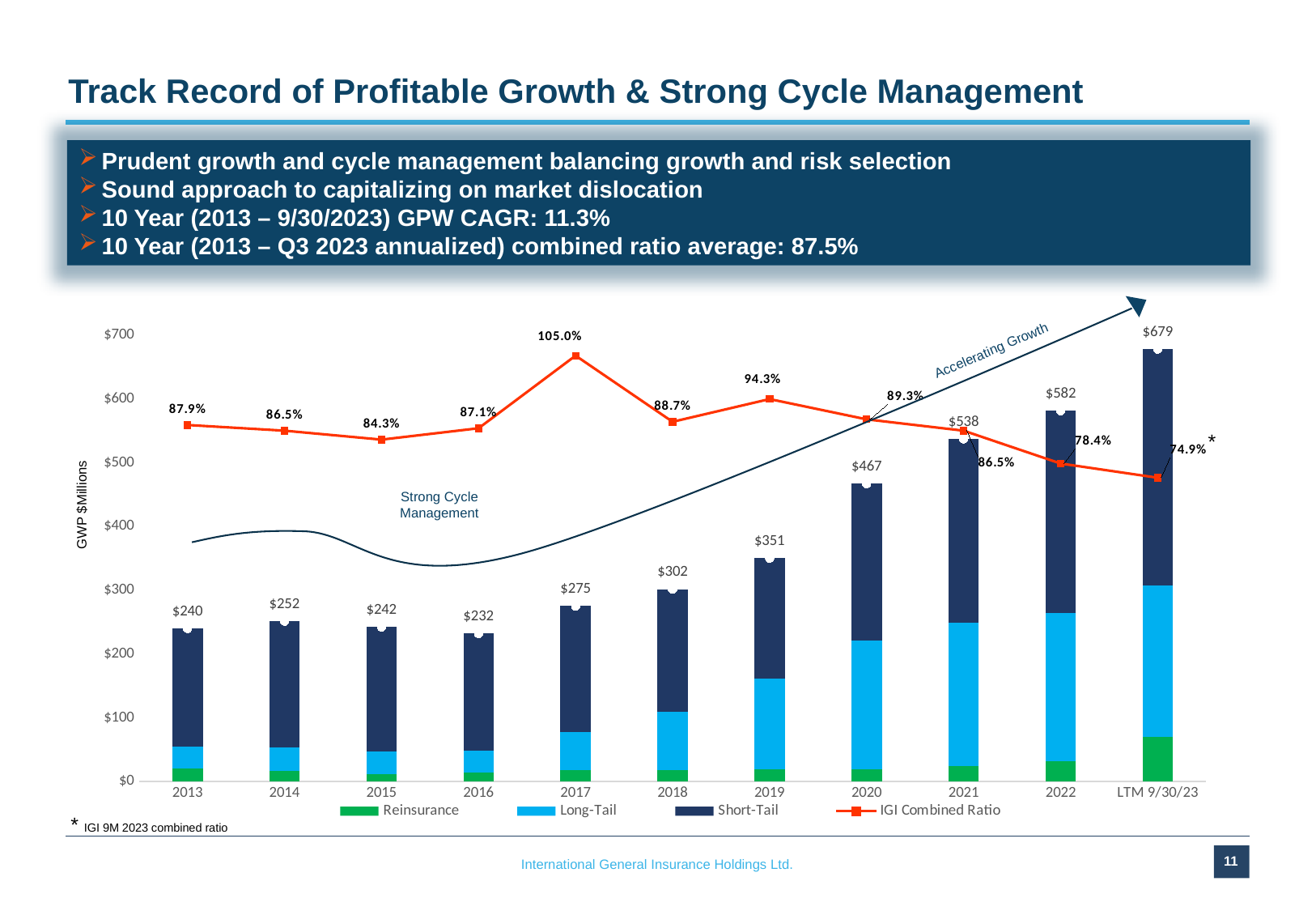
Do the total GPW values generally rise or fall from 2016 to LTM 9/30/23? rise What is the total GPW value labeled for LTM 9/30/23? $679 Which year has the highest IGI Combined Ratio? 2017 What is the IGI Combined Ratio shown for 2017? 105.0% Which year has the lowest total GPW? 2016 How many periods are shown on the x axis? 11 Which is larger, the total GPW for 2014 or 2015? 2014 How many series does the legend list? 4 What is the total GPW value labeled for 2020? $467 Which period has the lowest IGI Combined Ratio? LTM 9/30/23 What is the difference between the total GPW for 2022 and 2021? $44